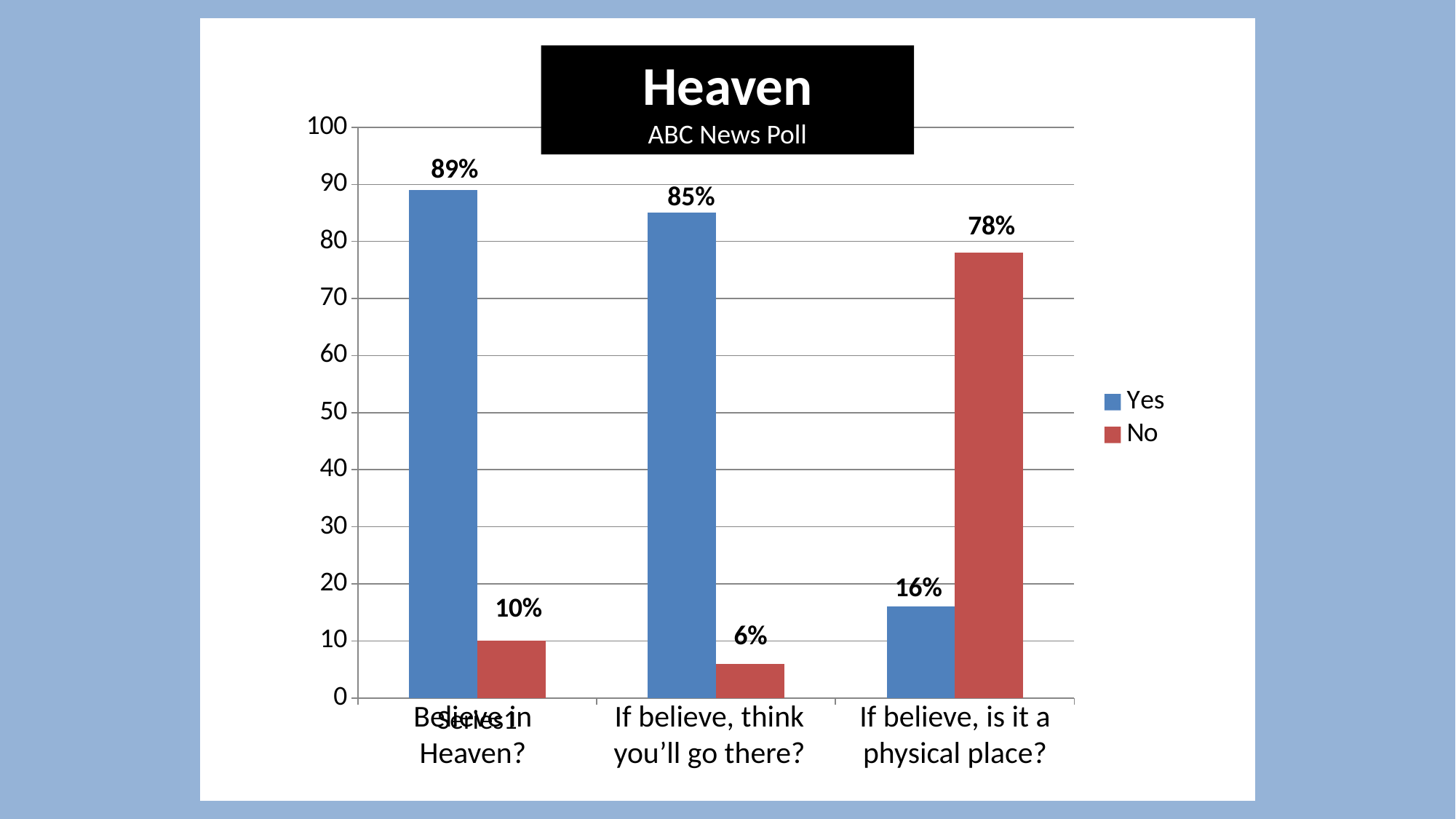
What is the subtitle shown under the chart title "Heaven"? ABC News Poll Which category has the highest Yes value? Believe in Heaven? What is the No value for "If believe, think you'll go there?"? 6% What is the Yes value for "If believe, is it a physical place?"? 16% What is the difference between the Yes and No values for "Believe in Heaven?"? 79% What is the Yes value for "Believe in Heaven?"? 89% What is the No value for "If believe, is it a physical place?"? 78% Which category has the lowest No value? If believe, think you'll go there? How many series does the legend list? 2 How many categories are shown on the x axis? 3 What kind of chart is shown? Bar chart For "If believe, is it a physical place?", which is larger, Yes or No? No